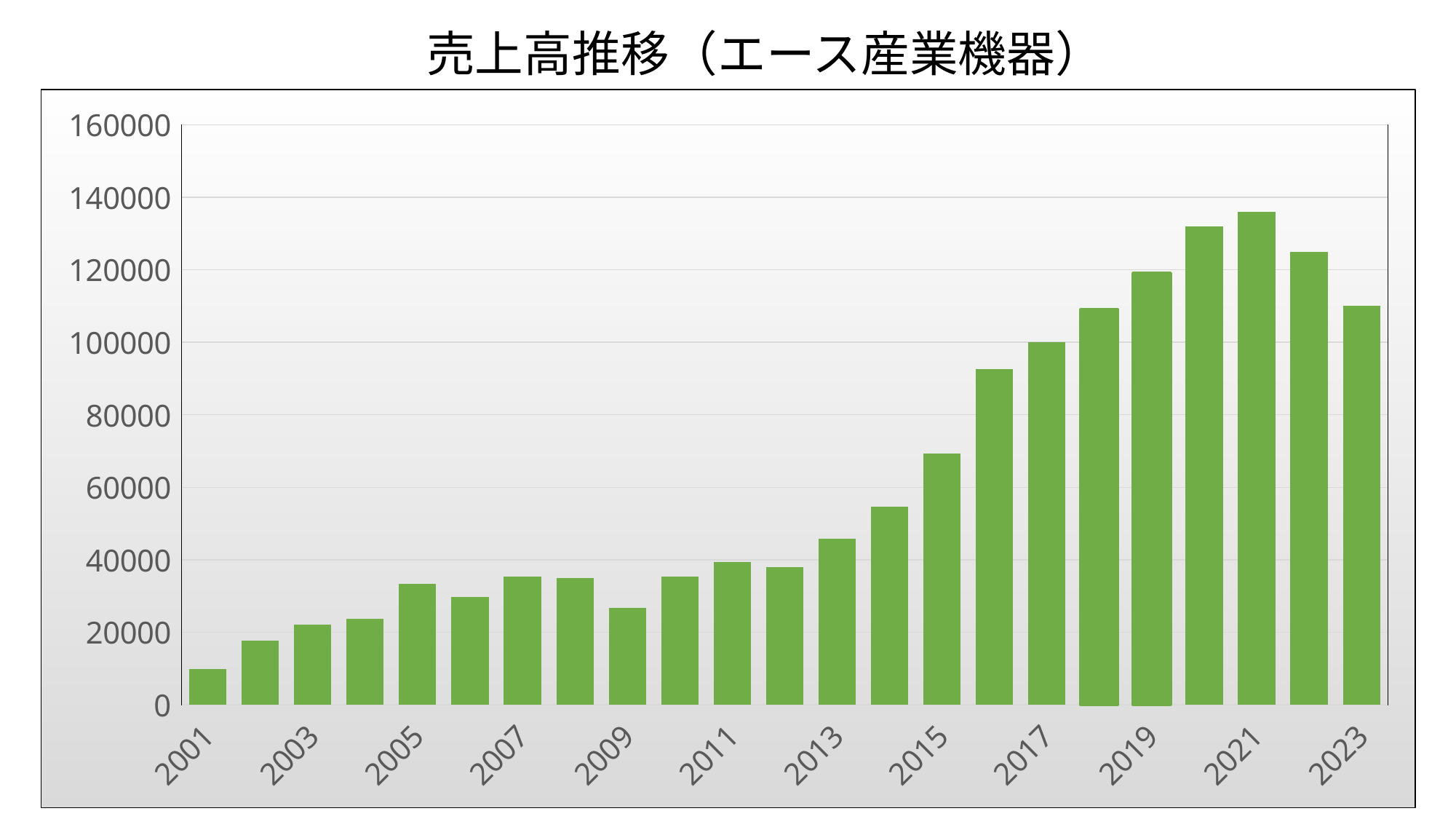
How many years (bars) are plotted in the chart? 23 Which is larger, the value for 2022 or the value for 2023? 2022 Is the value for 2020 greater or less than 120000? greater Is the value for 2009 greater or less than 40000? less Is the value for 2023 greater or less than 100000? greater Do the values generally rise or fall from 2001 to 2021? rise What kind of chart is shown on the slide? bar chart Which year has the lowest value in the chart? 2001 What is the title of the chart? 売上高推移（エース産業機器） Which year has the highest value in the chart? 2021